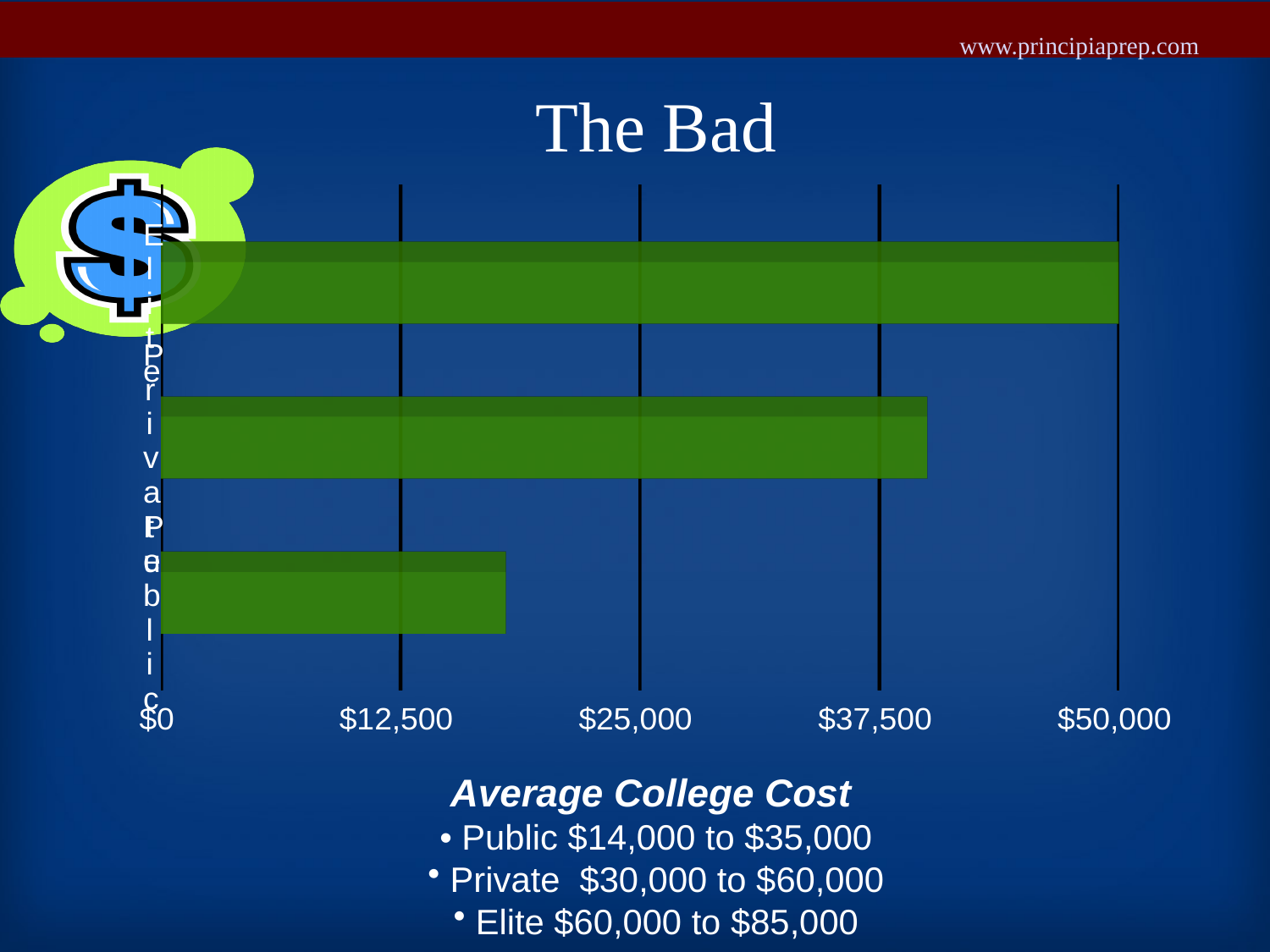
Is the value of the bottom bar greater or less than $12,500? greater Is the value of the middle bar greater or less than $50,000? less What value does the top bar reach on the x axis? $50,000 How many bars are plotted in the chart? 3 What colour are the bars in the chart? green Which bar is the shortest: the top, middle, or bottom bar? bottom Is the value of the middle bar greater or less than $37,500? greater Which bar has the larger value, the middle bar or the bottom bar? middle Which bar is the longest: the top, middle, or bottom bar? top What is the title of the slide containing the chart? The Bad What kind of chart is shown on the slide? bar chart